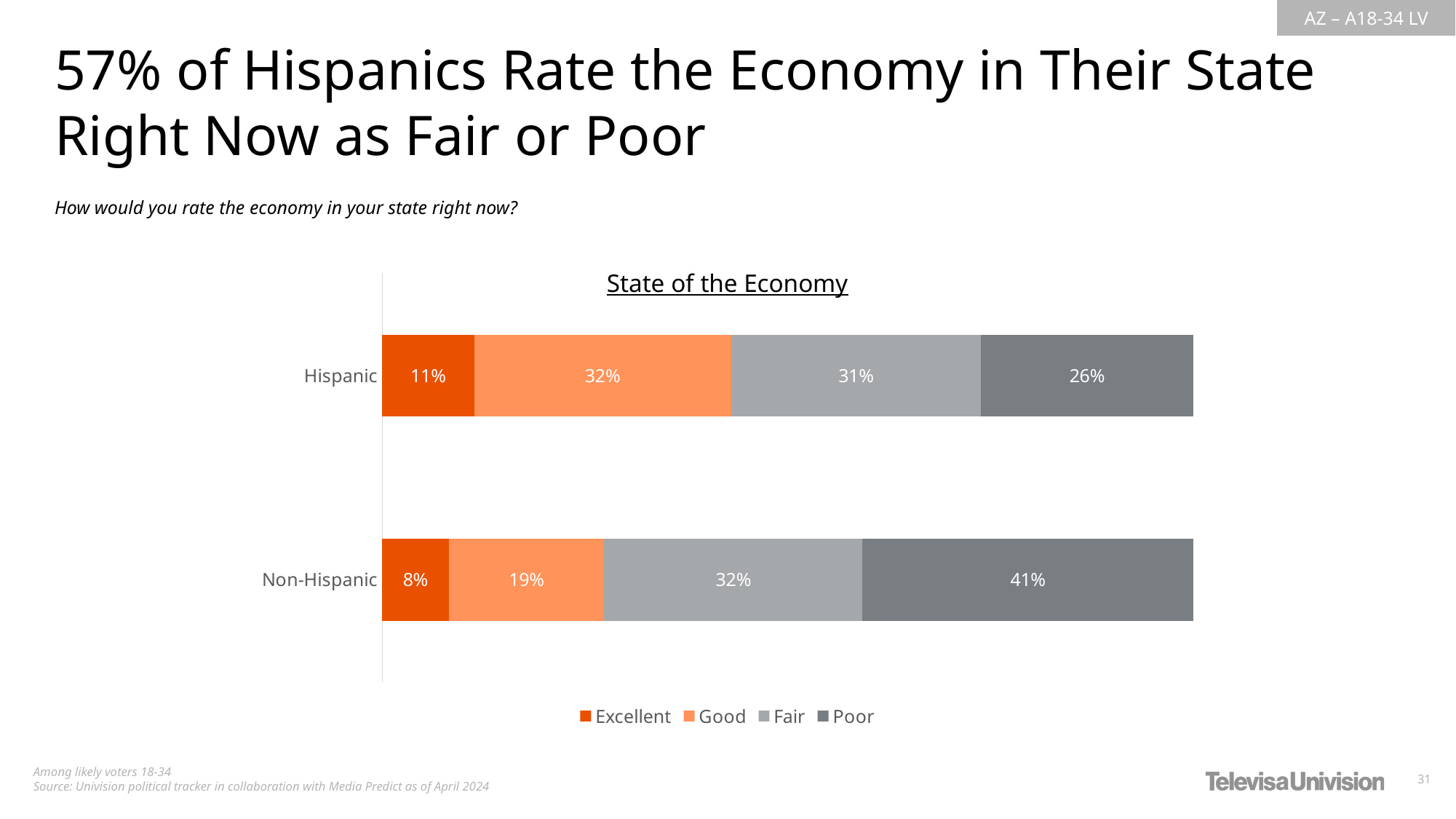
What type of chart is shown on the slide? Stacked bar chart What is the difference between the Poor share for Non-Hispanic respondents and the Poor share for Hispanic respondents? 15 percentage points What is the combined share of Hispanic respondents rating the economy as Fair or Poor? 57% What percentage of Hispanic respondents rate the economy as Good? 32% Which rating category has the largest share among Non-Hispanic respondents? Poor What percentage of Hispanic respondents rate the economy in their state as Excellent? 11% What is the title of the chart? State of the Economy What percentage of Non-Hispanic respondents rate the economy as Fair? 32% Which group has a larger share rating the economy as Good, Hispanic or Non-Hispanic? Hispanic Which rating category has the smallest share among Hispanic respondents? Excellent How many series does the legend list? 4 What percentage of Non-Hispanic respondents rate the economy in their state as Poor? 41%